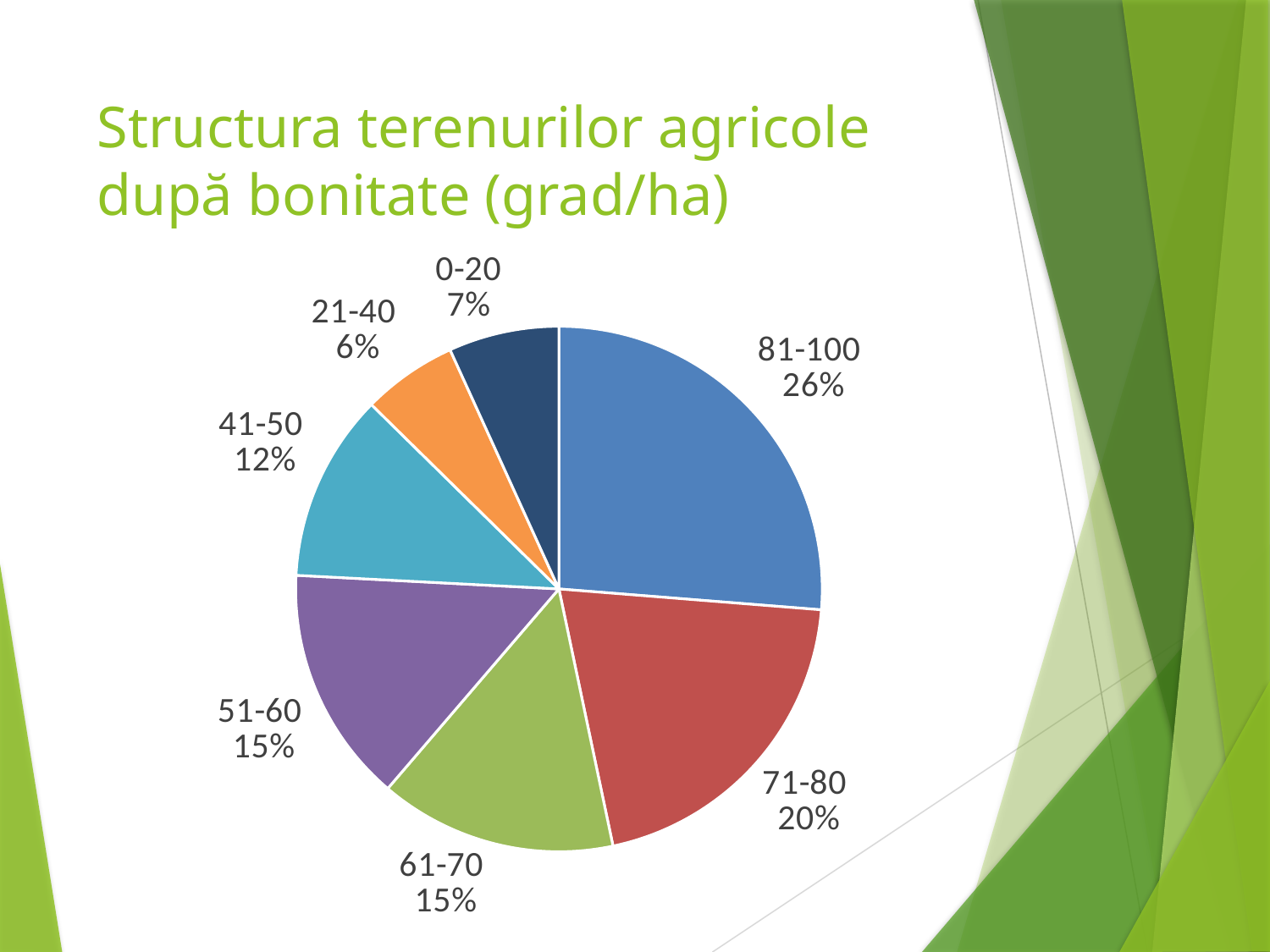
What share of the pie does the 41-50 category have? 12% What is the combined share of the 51-60 and 61-70 slices? 30% What is the title of the chart on the slide? Structura terenurilor agricole după bonitate (grad/ha) What share of the pie does the 71-80 category have? 20% Which category has the largest slice of the pie? 81-100 Which category has the smallest slice of the pie? 21-40 How many categories are shown in the pie chart? 7 What share of the pie does the 81-100 category have? 26% What is the difference in percentage points between the 81-100 slice and the 71-80 slice? 6 Which slice is larger, 41-50 or 51-60? 51-60 What share of the pie does the 0-20 category have? 7% What kind of chart is shown on the slide? pie chart